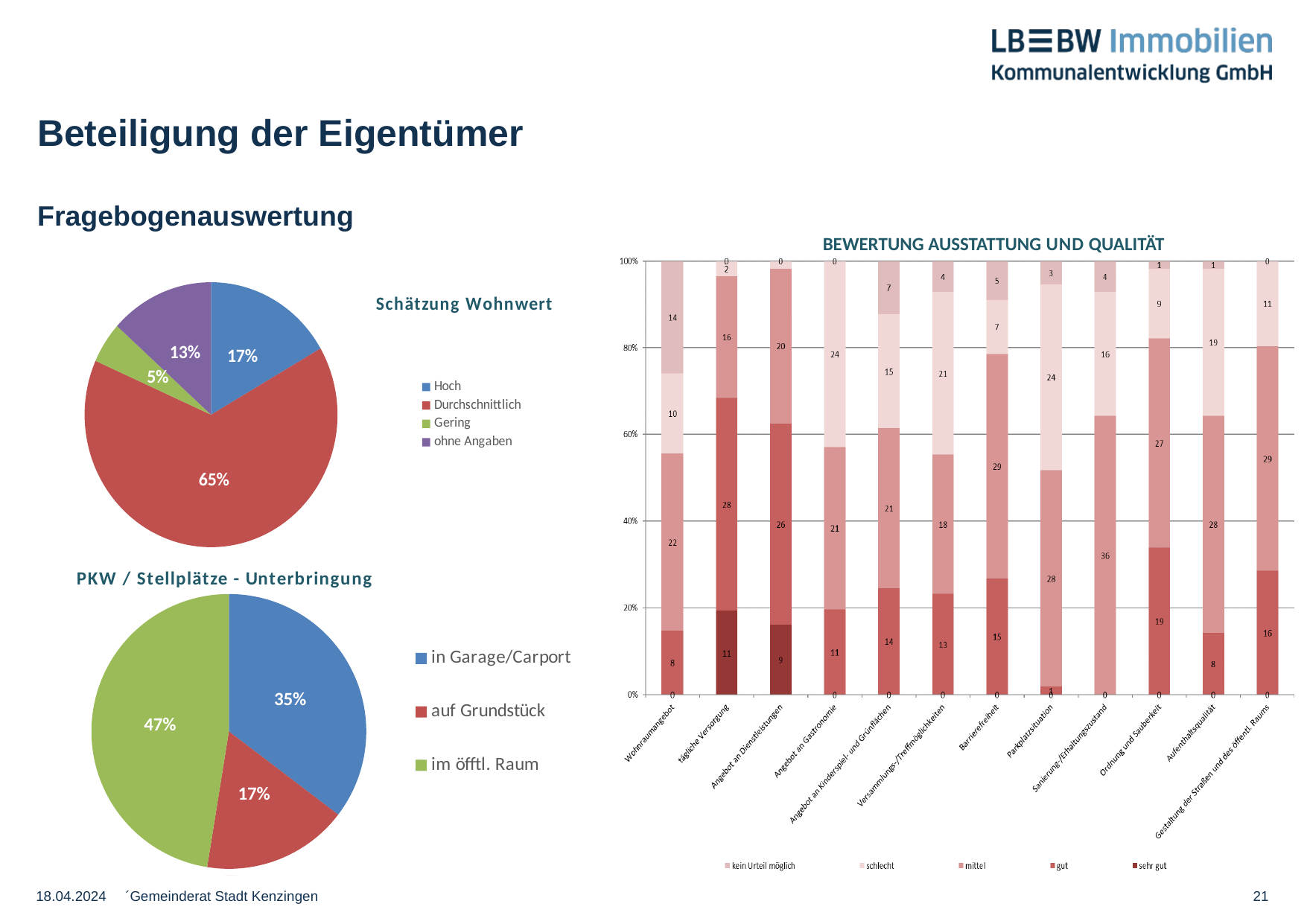
In the 'PKW / Stellplätze - Unterbringung' pie chart, what share is 'in Garage/Carport'? 35% In the 'PKW / Stellplätze - Unterbringung' pie chart, which category has the largest share? im öfftl. Raum In the 'Schätzung Wohnwert' pie chart, what share is labelled 'Durchschnittlich'? 65% In the 'BEWERTUNG AUSSTATTUNG UND QUALITÄT' chart, what is the 'mittel' value for 'Sanierung-/Erhaltungszustand'? 36 How many categories are shown on the x axis of the 'BEWERTUNG AUSSTATTUNG UND QUALITÄT' chart? 12 In the 'PKW / Stellplätze - Unterbringung' pie chart, how many categories does the legend list? 3 In the 'BEWERTUNG AUSSTATTUNG UND QUALITÄT' chart, what is the 'gut' value for 'tägliche Versorgung'? 28 In the 'Schätzung Wohnwert' pie chart, what is the difference between the 'Hoch' share and the 'ohne Angaben' share? 4% In the 'Schätzung Wohnwert' pie chart, which category has the smallest share? Gering In the 'BEWERTUNG AUSSTATTUNG UND QUALITÄT' chart, which is larger: the 'schlecht' value for 'Angebot an Gastronomie' or the 'schlecht' value for 'Wohnraumangebot'? Angebot an Gastronomie How many series does the legend of the 'BEWERTUNG AUSSTATTUNG UND QUALITÄT' chart list? 5 What kind of chart is 'BEWERTUNG AUSSTATTUNG UND QUALITÄT'? Stacked bar chart